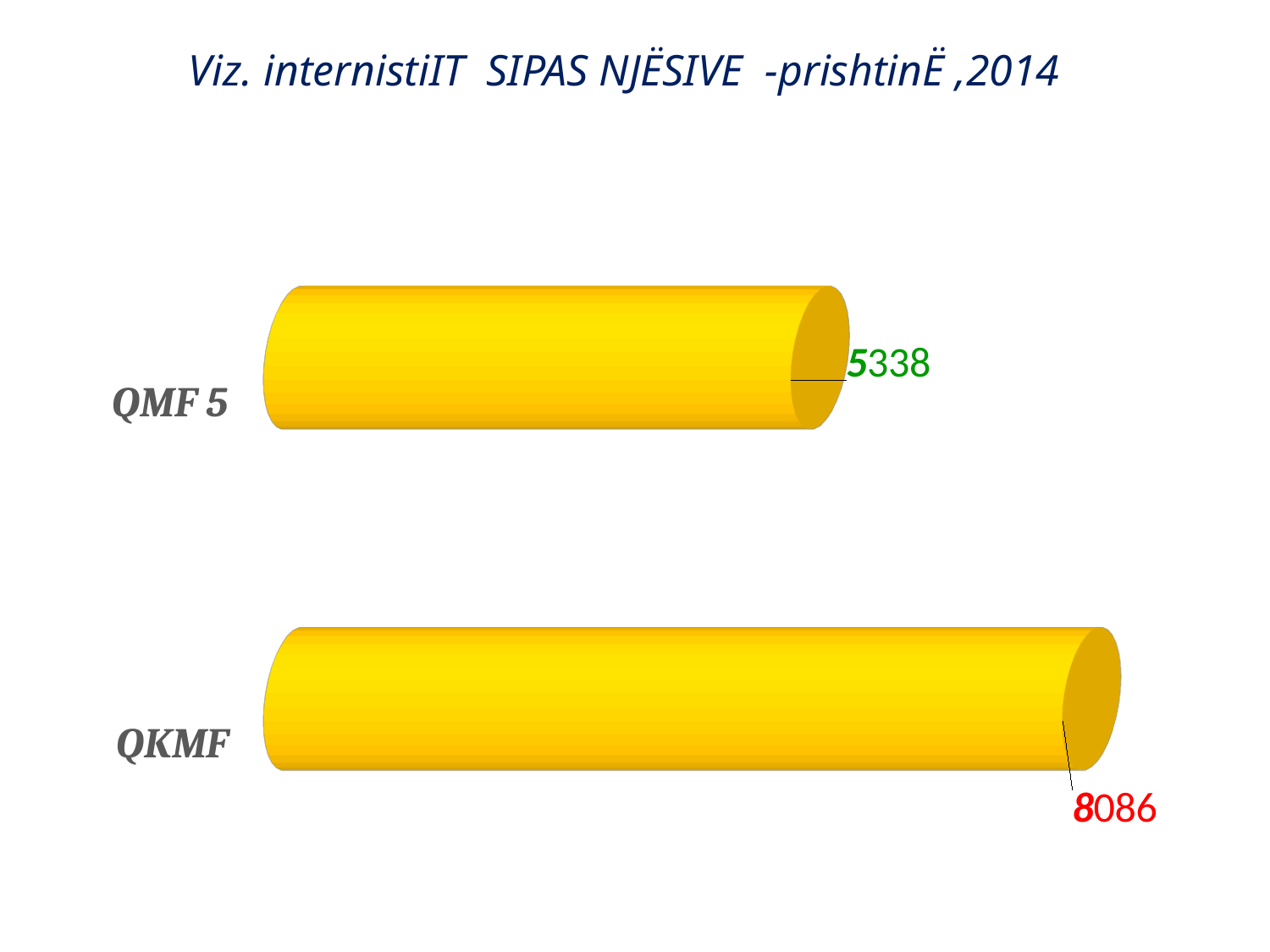
What is the title of the chart? Viz. internistiIT SIPAS NJËSIVE -prishtinË ,2014 What kind of chart is shown on the slide? bar chart What is the total of the two values shown in the chart? 13424 How many categories are shown in the chart? 2 What is the difference between the values for QKMF and QMF 5? 2748 What colour are the bars in the chart? yellow Which is larger, the value for QKMF or the value for QMF 5? QKMF What is the value for QMF 5? 5338 What is the value for QKMF? 8086 Which category has the lowest value? QMF 5 Which category has the highest value? QKMF